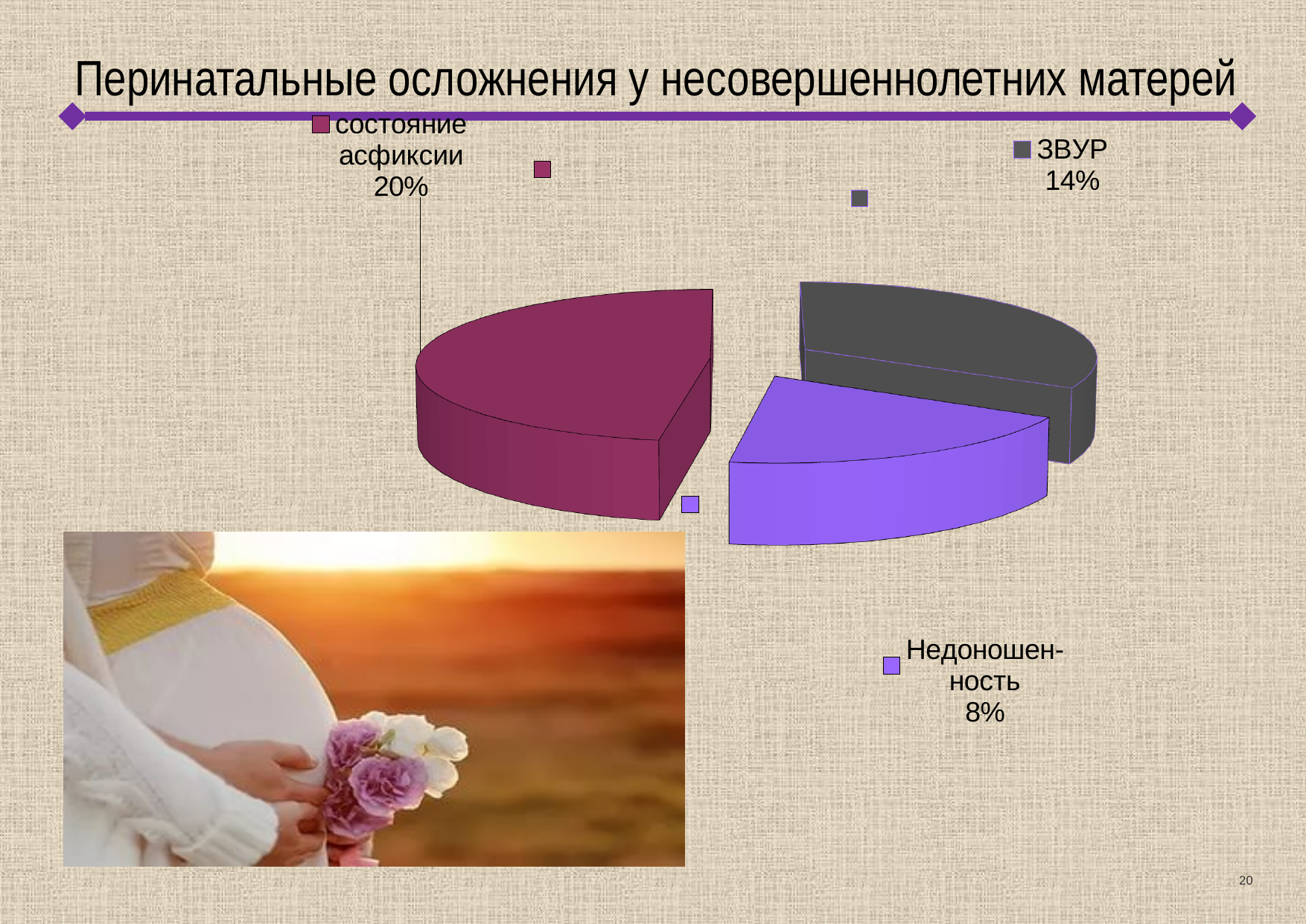
What is the difference between the values for "состояние асфиксии" and "Недоношенность"? 12% What percentage is shown for the slice "ЗВУР"? 14% What kind of chart is shown on the slide? pie chart Which slice of the pie chart has the smallest value? Недоношенность What percentage is shown for the slice "Недоношенность"? 8% Which slice of the pie chart has the largest value? состояние асфиксии Which is larger, the value for "ЗВУР" or the value for "Недоношенность"? ЗВУР What colour is the slice labelled "ЗВУР"? dark grey What is the difference between the values for "состояние асфиксии" and "ЗВУР"? 6% What is the title of the slide containing the pie chart? Перинатальные осложнения у несовершеннолетних матерей What percentage is shown for the slice "состояние асфиксии"? 20% How many slices does the pie chart have? 3